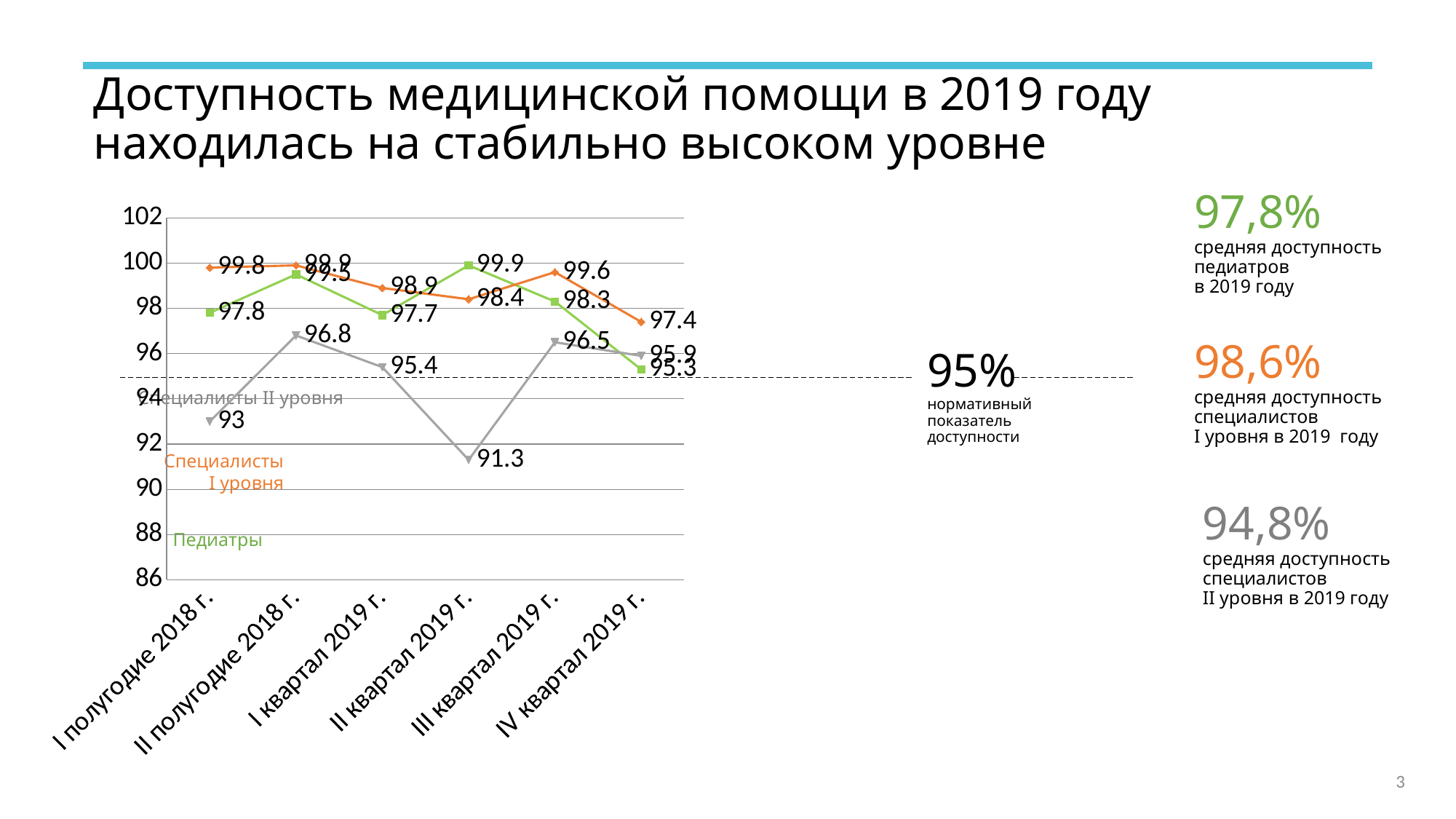
In I квартал 2019 г., which series has the larger value: Специалисты I уровня or Педиатры? Специалисты I уровня Does the value for Специалисты II уровня rise or fall from II квартал 2019 г. to III квартал 2019 г.? rise How many series are plotted on the chart? 3 What is the value for Специалисты II уровня in II квартал 2019 г.? 91.3 What is the value for Педиатры in IV квартал 2019 г.? 95.3 In which period is the value for Специалисты II уровня lowest? II квартал 2019 г. What is the value for Специалисты I уровня in I полугодие 2018 г.? 99.8 What kind of chart is shown on the slide? line chart In which period is the value for Педиатры highest? II квартал 2019 г. How many periods are shown on the x axis? 6 What is the normative availability indicator (нормативный показатель доступности) marked by the dashed line? 95% What is the difference between the Специалисты I уровня values in III квартал 2019 г. and IV квартал 2019 г.? 2.2